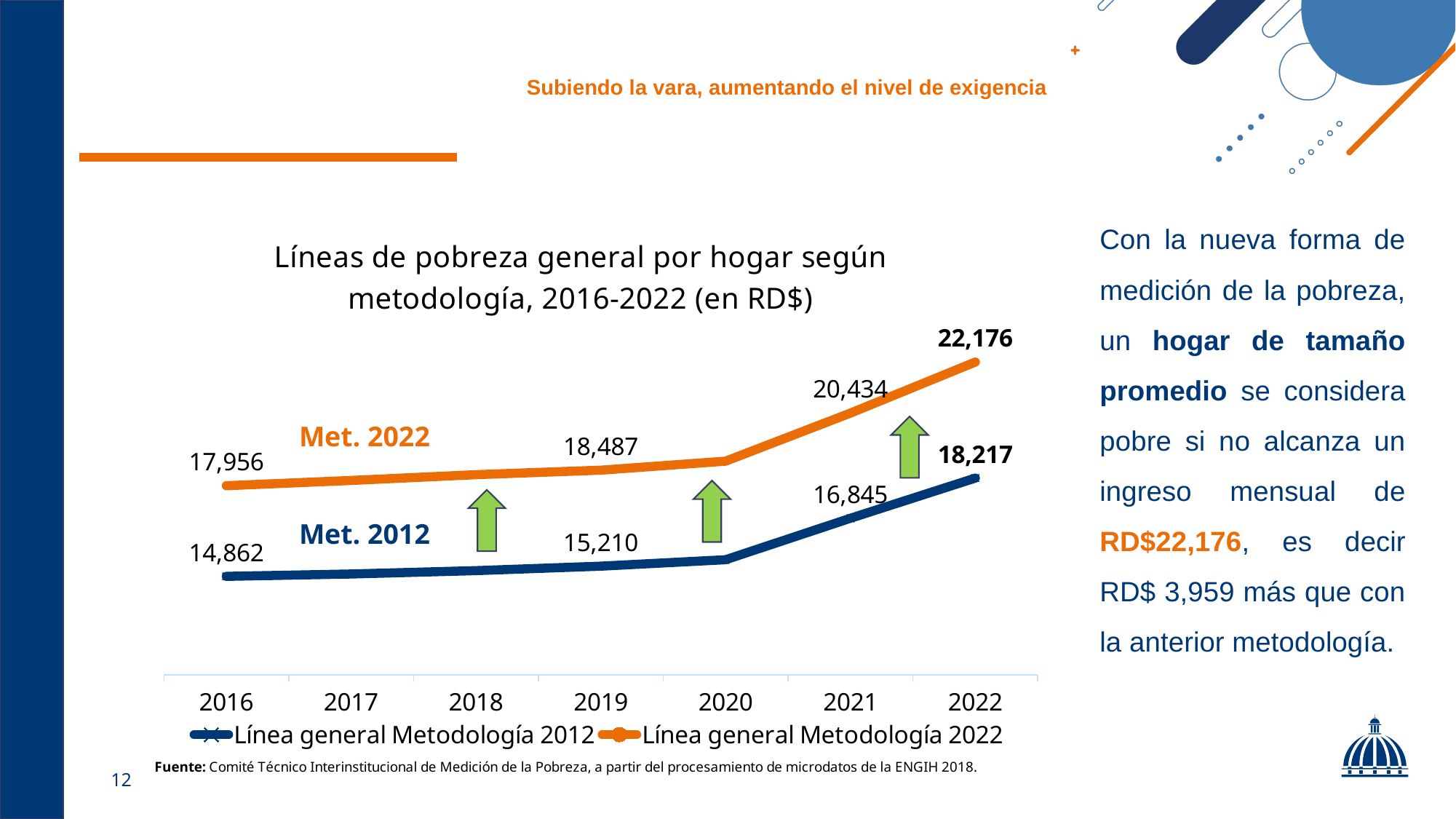
What is the difference between the two methodologies' poverty lines in 2022? 3,959 Do the poverty line values rise or fall from 2016 to 2022? Rise What is the value of the Línea general Metodología 2012 series in 2016? 14,862 What is the title of the chart? Líneas de pobreza general por hogar según metodología, 2016-2022 (en RD$) What is the value of the Línea general Metodología 2012 series in 2022? 18,217 What is the value of the Línea general Metodología 2022 series in 2022? 22,176 How many series does the chart legend list? 2 What is the value of the Línea general Metodología 2022 series in 2016? 17,956 What type of chart is shown on the slide? Line chart Which series has the higher values throughout the chart, Metodología 2012 or Metodología 2022? Línea general Metodología 2022 How many years are shown on the x axis of the chart? 7 What is the difference between the two methodologies' poverty lines in 2016? 3,094